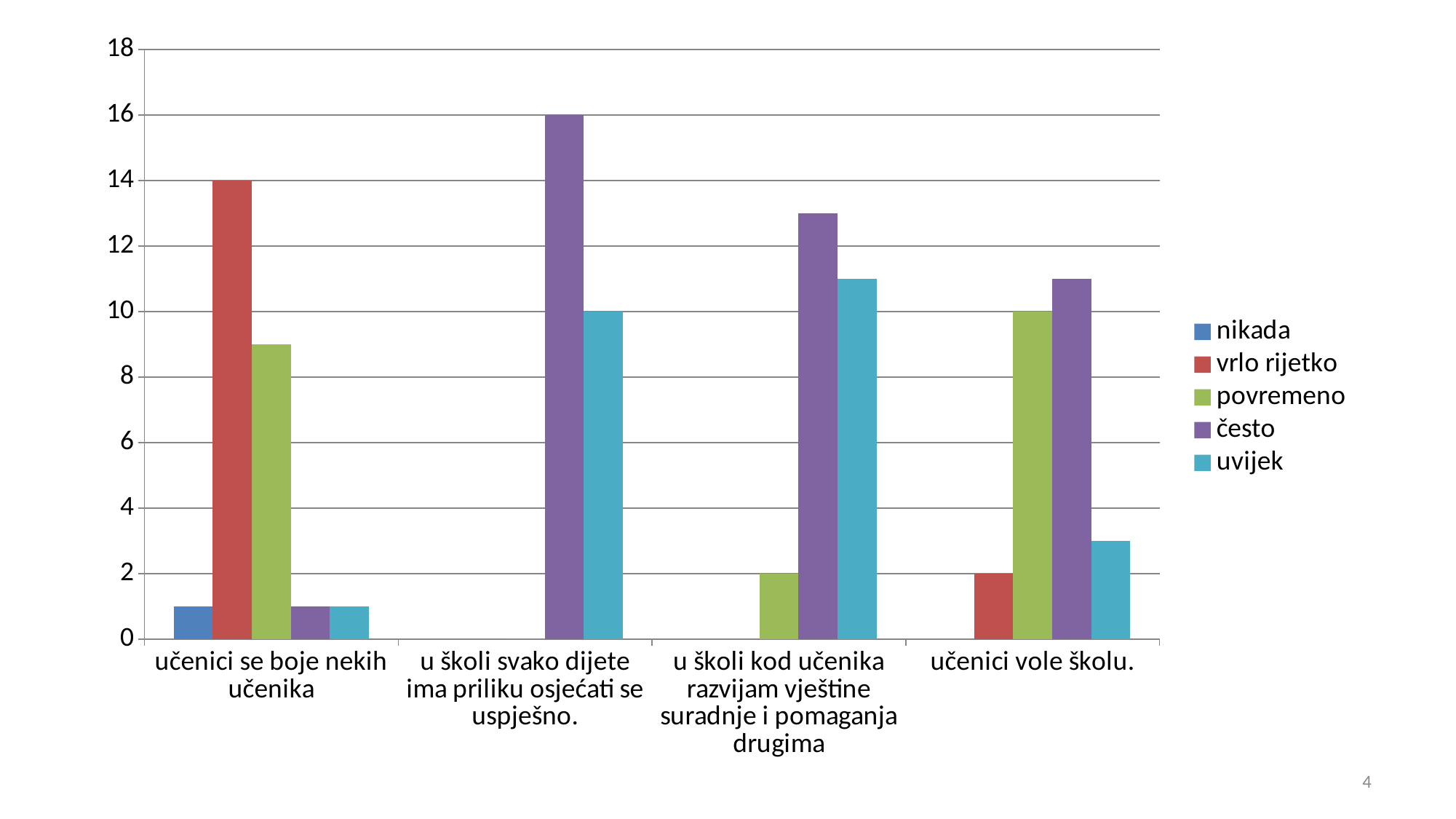
How many series does the legend list? 5 Is the value of 'često' for 'u školi kod učenika razvijam vještine suradnje i pomaganja drugima' greater or less than 12? greater What is the value of 'često' for 'u školi svako dijete ima priliku osjećati se uspješno.'? 16 How many categories are shown on the x axis? 4 What is the value of 'povremeno' for 'učenici vole školu.'? 10 Which series has the highest value for 'u školi kod učenika razvijam vještine suradnje i pomaganja drugima'? često What is the value of 'vrlo rijetko' for 'učenici vole školu.'? 2 What is the value of 'uvijek' for 'u školi svako dijete ima priliku osjećati se uspješno.'? 10 What is the difference between 'često' and 'uvijek' for 'u školi svako dijete ima priliku osjećati se uspješno.'? 6 What kind of chart is shown on the slide? bar chart What is the value of 'vrlo rijetko' for 'učenici se boje nekih učenika'? 14 Which is larger: 'vrlo rijetko' for 'učenici se boje nekih učenika' or 'povremeno' for 'učenici se boje nekih učenika'? vrlo rijetko